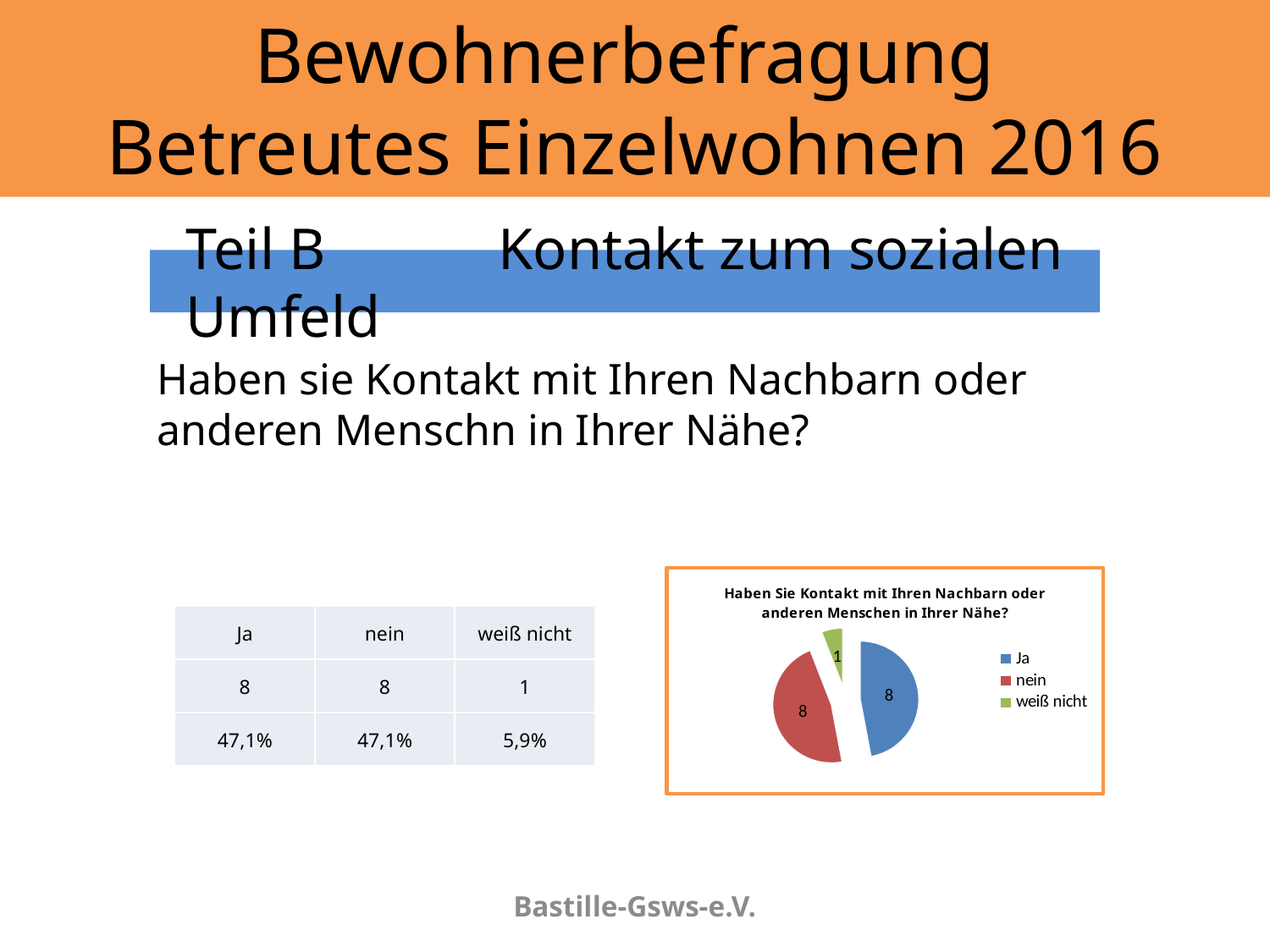
What colour is the "nein" slice in the pie chart? red What kind of chart is shown on the slide? pie chart What is the total of all values shown in the pie chart? 17 Which is larger in the pie chart, the value for "Ja" or the value for "weiß nicht"? Ja Which category has the smallest slice in the pie chart? weiß nicht What share of the pie does the "weiß nicht" slice represent? 5,9% What is the value shown for the "nein" slice in the pie chart? 8 What is the value shown for the "weiß nicht" slice in the pie chart? 1 What is the difference between the values for "nein" and "weiß nicht" in the pie chart? 7 How many entries does the legend of the pie chart list? 3 How many slices does the pie chart have? 3 What is the value shown for the "Ja" slice in the pie chart? 8